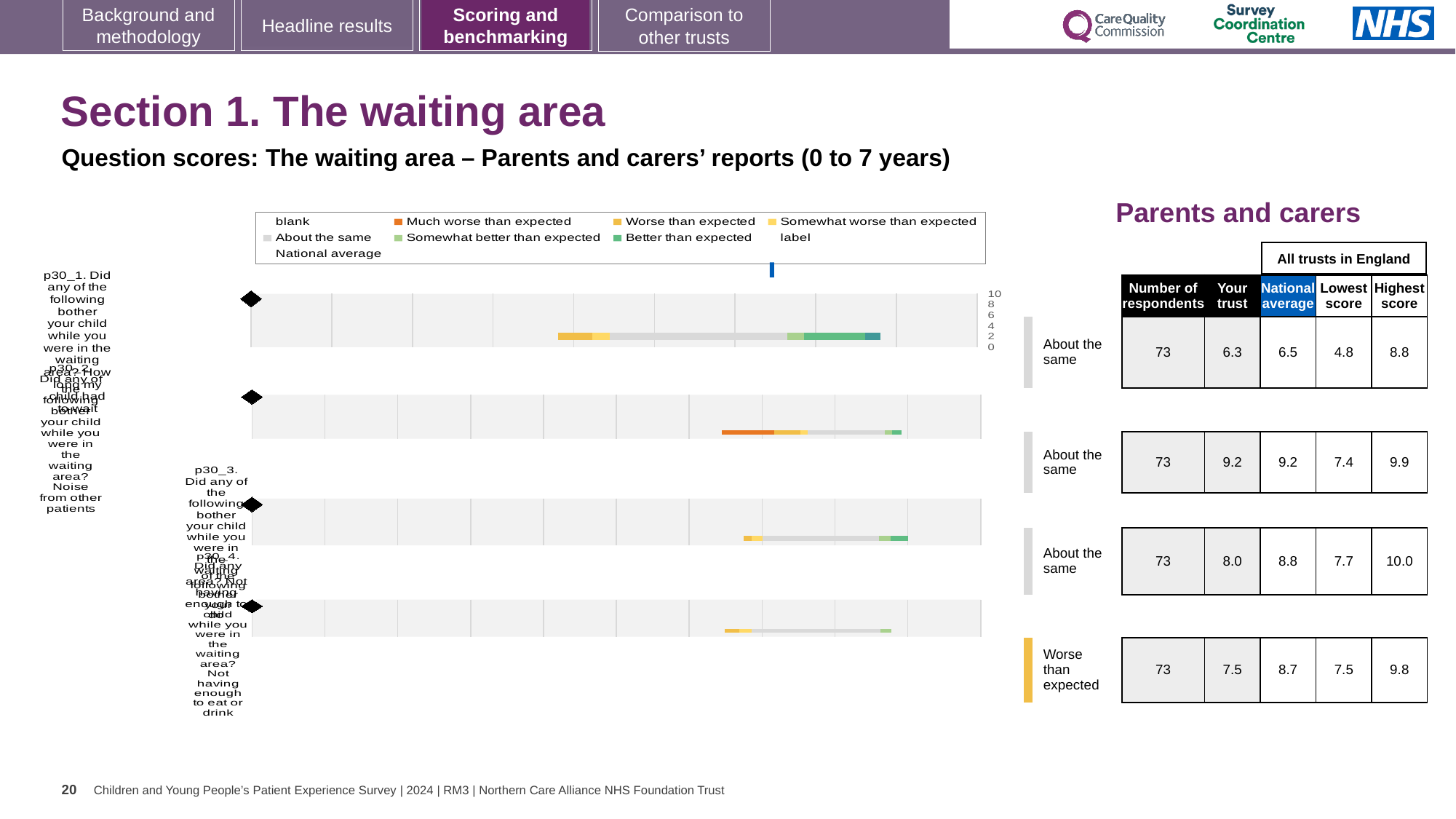
What colour represents 'Better than expected' in the chart legend? green Which question row is rated 'Worse than expected' rather than 'About the same'? The fourth row How many entries does the chart legend list? 9 What kind of chart is used to show the question scores on this slide? bar chart What is the maximum value shown on the chart's score axis? 10 How many question bars (rows) are plotted on the slide? 4 In the table beside the chart, what is the difference between the national average (8.7) and the trust score (7.5) for the fourth question row? 1.2 In the table beside the chart, which row has the highest 'Highest score' value, and what is it? The third row, 10.0 In the table beside the chart, what is the 'Your trust' score for the first question row? 6.3 In the table beside the chart, for the third question row, which is larger: the 'Your trust' score or the 'National average'? National average In the table beside the chart, how many respondents are listed for each question? 73